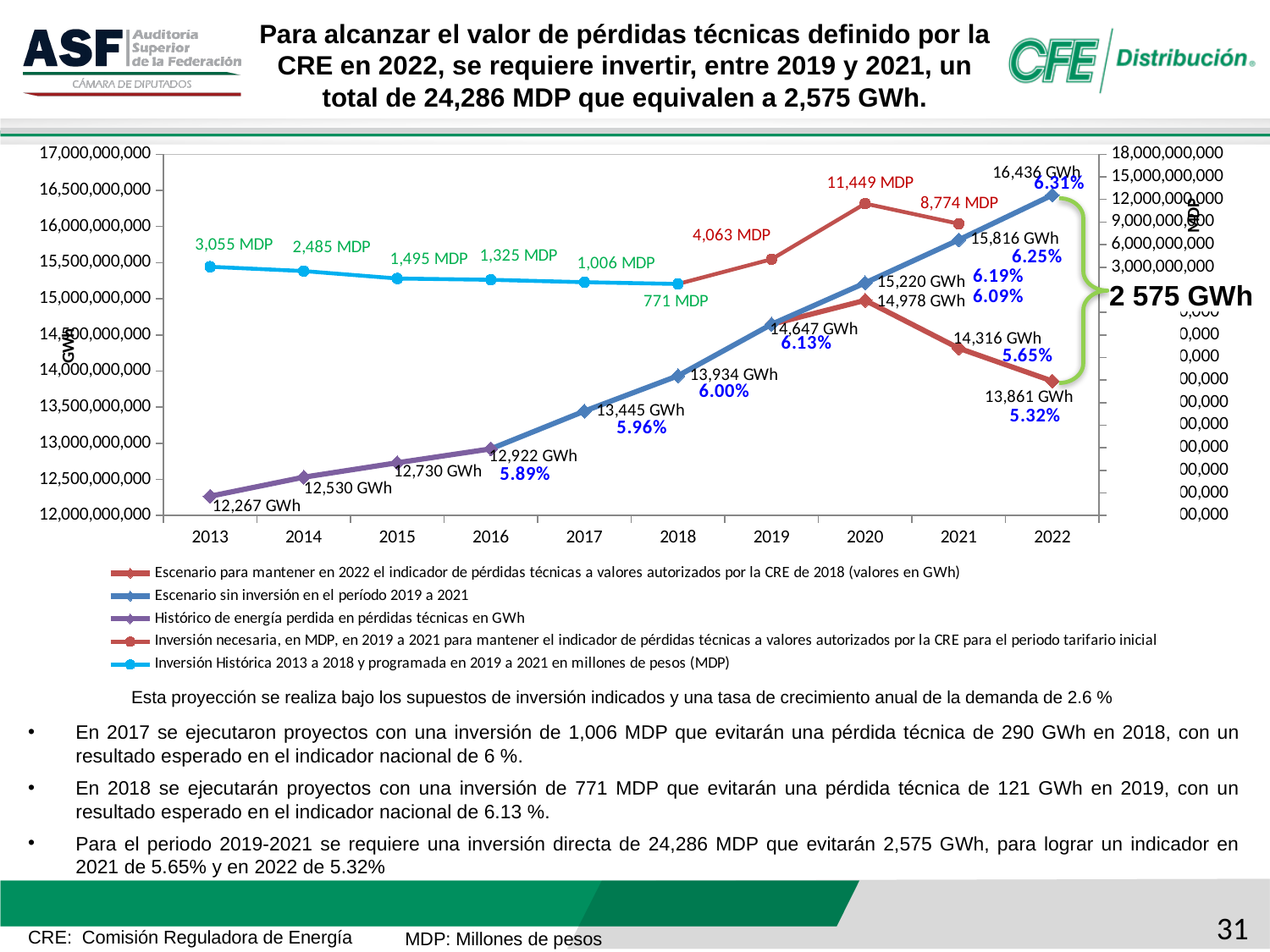
In which year is the historical investment (Inversión Histórica) highest? 2013 What is the 2022 value for the scenario that maintains the CRE-authorized technical loss indicator? 13,861 GWh How many series does the chart legend list? 5 What kind of chart is shown on the slide? Line chart What is the 2022 value for the scenario without investment (Escenario sin inversión)? 16,436 GWh What is the difference between the 2022 no-investment scenario value and the 2022 scenario with investment value? 2,575 GWh What is the necessary investment (Inversión necesaria) value for 2020? 11,449 MDP What is the historical investment (Inversión Histórica) value for 2014? 2,485 MDP Does the historical investment (Inversión Histórica) rise or fall from 2013 to 2018? Fall How many years are shown on the x axis of the chart? 10 What is the historical technical energy loss value for 2013? 12,267 GWh In 2021, which is larger: the scenario without investment or the scenario that maintains the CRE-authorized indicator? Scenario without investment